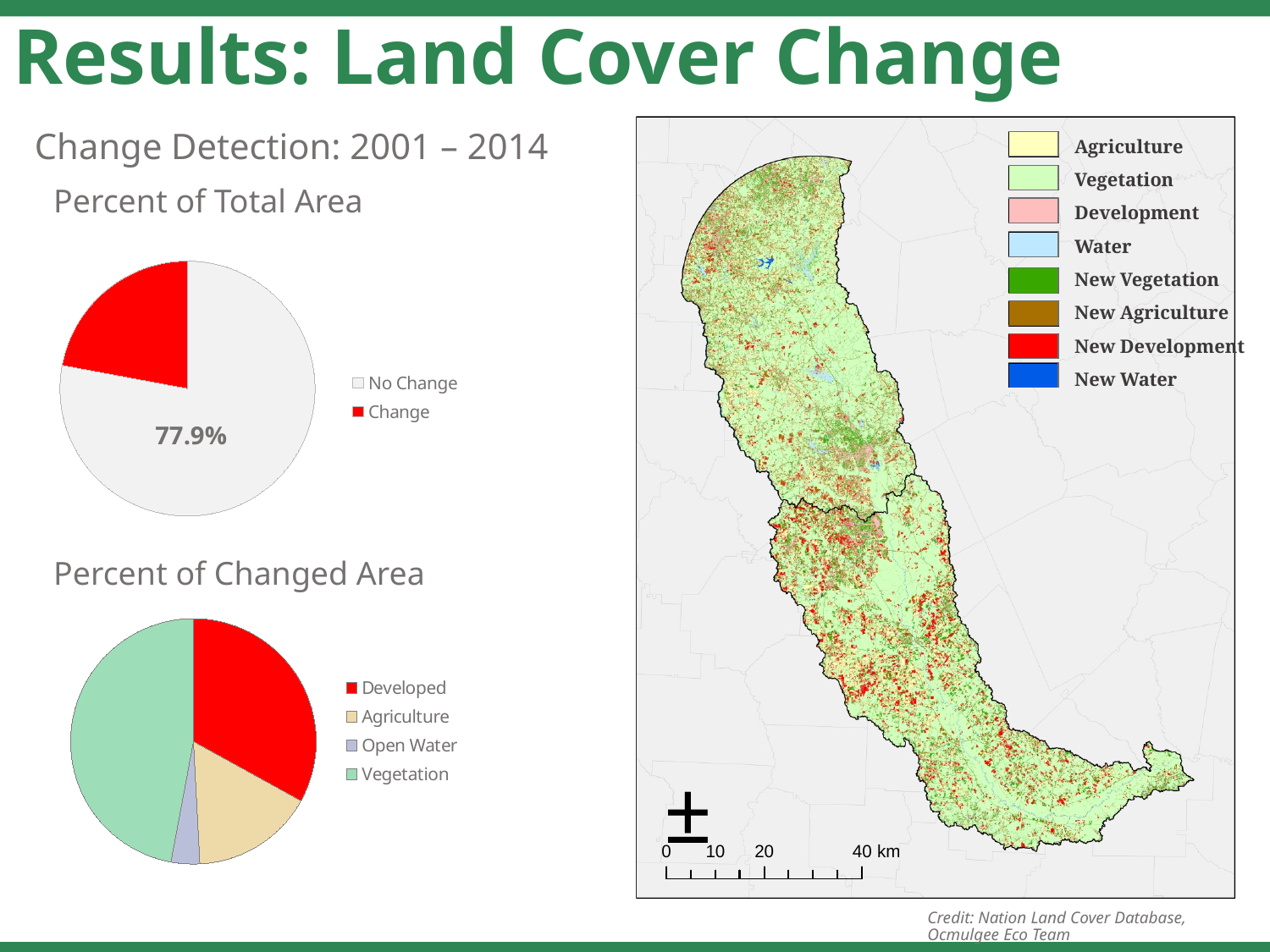
In the "Percent of Total Area" chart, which category has the largest slice? No Change In the "Percent of Changed Area" chart, which category has the smallest slice? Open Water How many categories does the legend of the "Percent of Total Area" chart list? 2 In the "Percent of Total Area" chart, is the value for No Change greater or less than 50%? greater What kind of chart is the "Percent of Total Area" chart? pie chart In the "Percent of Total Area" chart, what percentage is shown for No Change? 77.9% In the "Percent of Changed Area" chart, which category has the largest slice? Vegetation How many slices does the "Percent of Changed Area" pie chart have? 4 In the "Percent of Total Area" chart, what colour is the Change slice? red In the "Percent of Changed Area" chart, which slice is larger, Developed or Agriculture? Developed What are the legend entries of the "Percent of Changed Area" chart? Developed, Agriculture, Open Water, Vegetation In the "Percent of Changed Area" chart, which slice is larger, Open Water or Vegetation? Vegetation